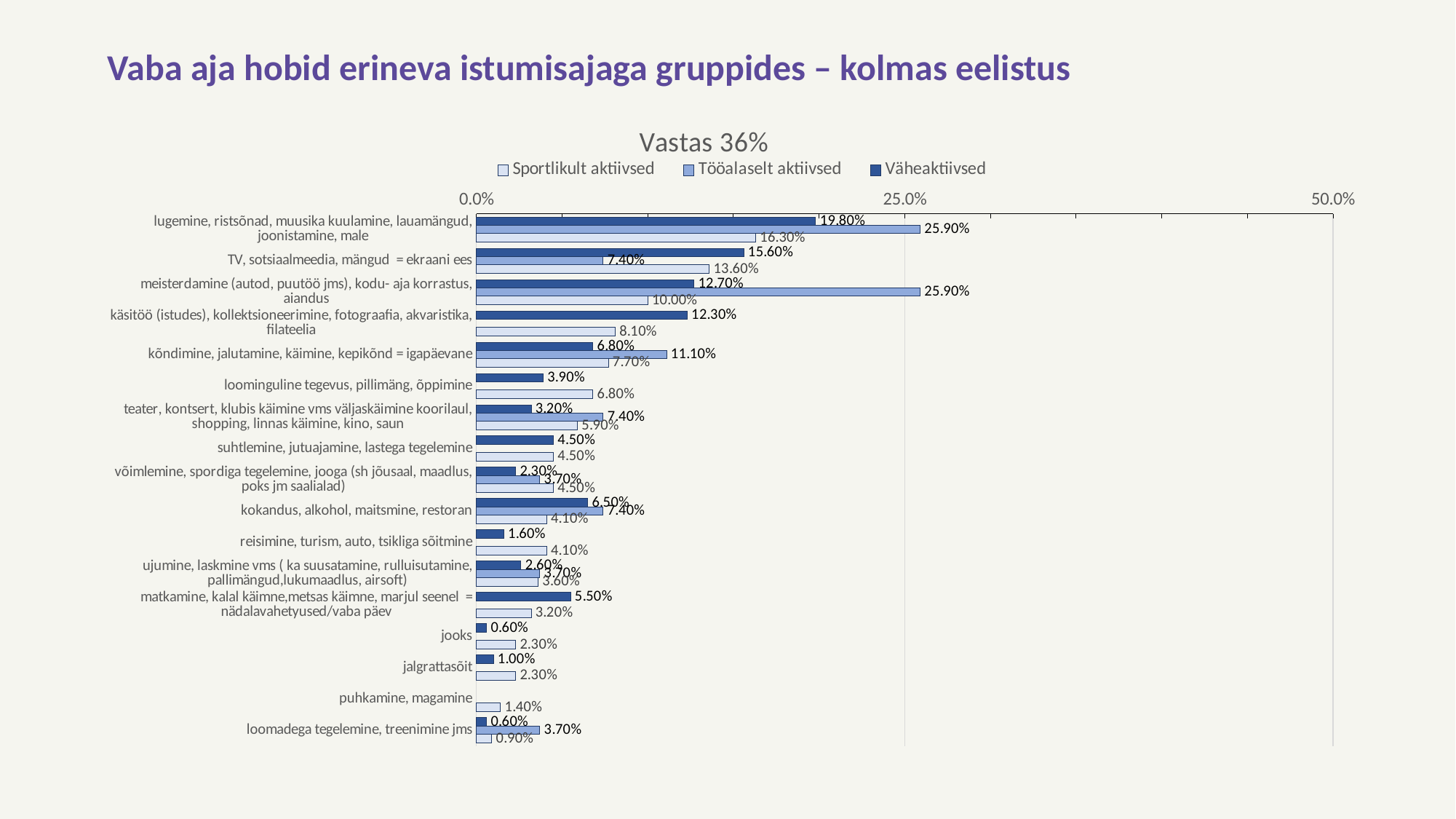
What is the Sportlikult aktiivsed value for 'lugemine, ristsõnad, muusika kuulamine, lauamängud, joonistamine, male'? 16.30% What is the difference between the Tööalaselt aktiivsed and Sportlikult aktiivsed values for 'meisterdamine (autod, puutöö jms), kodu- aja korrastus, aiandus'? 15.90% How many hobby categories are listed on the vertical axis? 17 What is the Tööalaselt aktiivsed value for 'kõndimine, jalutamine, käimine, kepikõnd = igapäevane'? 11.10% What is the Sportlikult aktiivsed value for 'puhkamine, magamine'? 1.40% What kind of chart is shown on the slide? bar chart For 'TV, sotsiaalmeedia, mängud = ekraani ees', which is larger: the Väheaktiivsed value or the Tööalaselt aktiivsed value? Väheaktiivsed What is the Väheaktiivsed value for 'TV, sotsiaalmeedia, mängud = ekraani ees'? 15.60% How many series does the legend list? 3 Which category has the highest Väheaktiivsed value? lugemine, ristsõnad, muusika kuulamine, lauamängud, joonistamine, male Is the Tööalaselt aktiivsed value for 'lugemine, ristsõnad, muusika kuulamine, lauamängud, joonistamine, male' greater or less than 25.0%? greater What is the chart's title? Vastas 36%